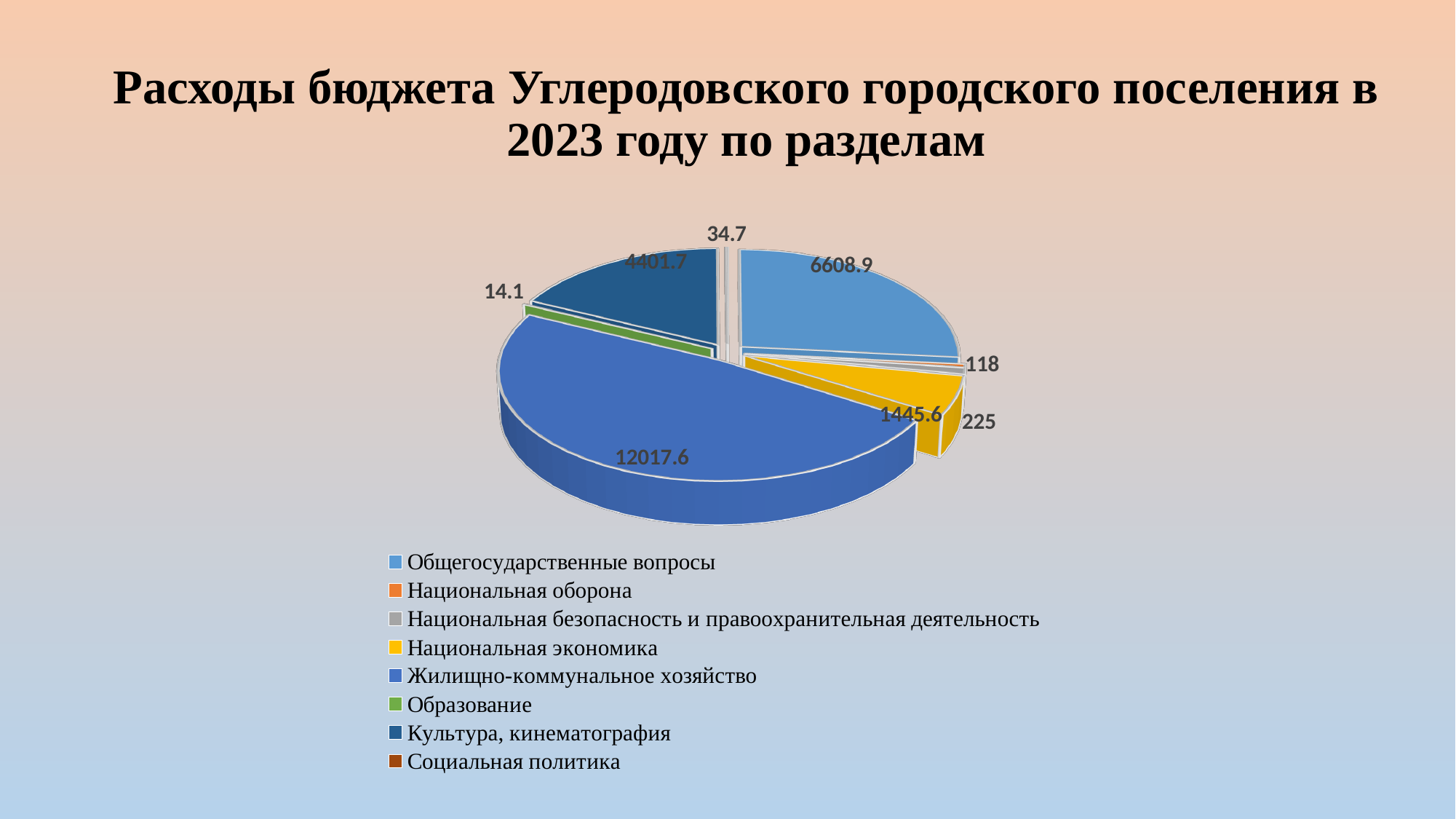
What is the title of the chart? Расходы бюджета Углеродовского городского поселения в 2023 году по разделам What kind of chart is shown on the slide? Pie chart What is the difference between the values for Жилищно-коммунальное хозяйство and Общегосударственные вопросы? 5408.7 What is the value for Национальная экономика? 1445.6 How many categories does the legend list? 8 What is the value for Жилищно-коммунальное хозяйство? 12017.6 Which category has the largest slice of the pie? Жилищно-коммунальное хозяйство What is the value for Общегосударственные вопросы? 6608.9 Which category has the smallest value? Образование What is the value for Образование? 14.1 Which is larger: Общегосударственные вопросы or Культура, кинематография? Общегосударственные вопросы What is the value for Культура, кинематография? 4401.7